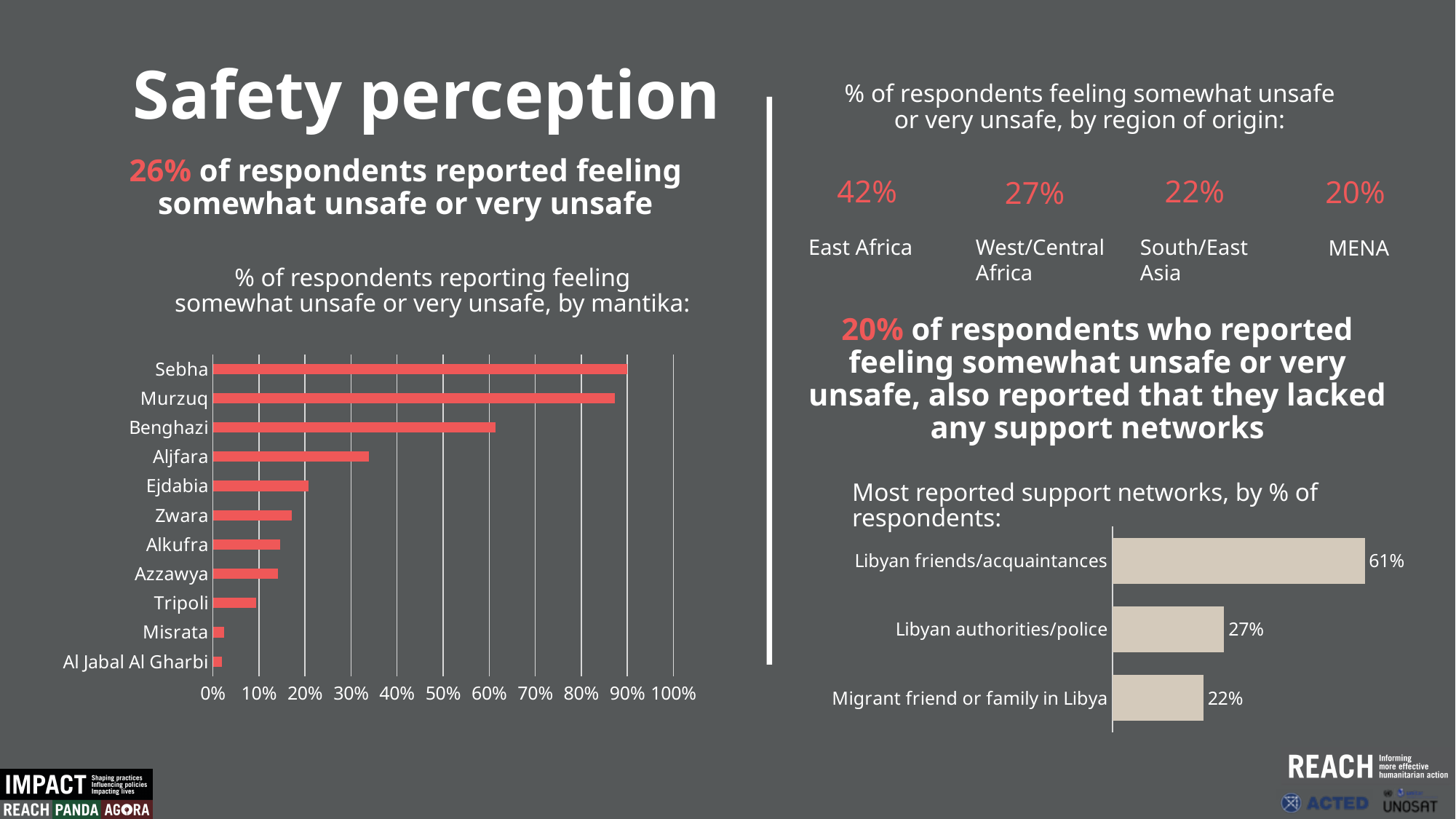
In the support networks chart on the right, how many support networks are shown? 3 What kind of chart is the chart on the left, showing % of respondents feeling unsafe by mantika? bar chart In the chart by mantika on the left, is the value for Benghazi greater or less than 50%? greater In the support networks chart on the right, what percentage of respondents reported Libyan friends/acquaintances? 61% In the chart by mantika on the left, is the value for Murzuq greater or less than 80%? greater In the chart by mantika on the left, how many mantikas are listed? 11 In the chart by mantika on the left, is the value for Tripoli greater or less than 20%? less In the support networks chart on the right, what percentage of respondents reported Migrant friend or family in Libya? 22% In the support networks chart on the right, what is the difference between Libyan friends/acquaintances and Libyan authorities/police? 34 percentage points In the chart by mantika on the left, which mantika has the highest percentage of respondents feeling somewhat or very unsafe? Sebha In the chart by mantika on the left, which has a higher value, Benghazi or Aljfara? Benghazi